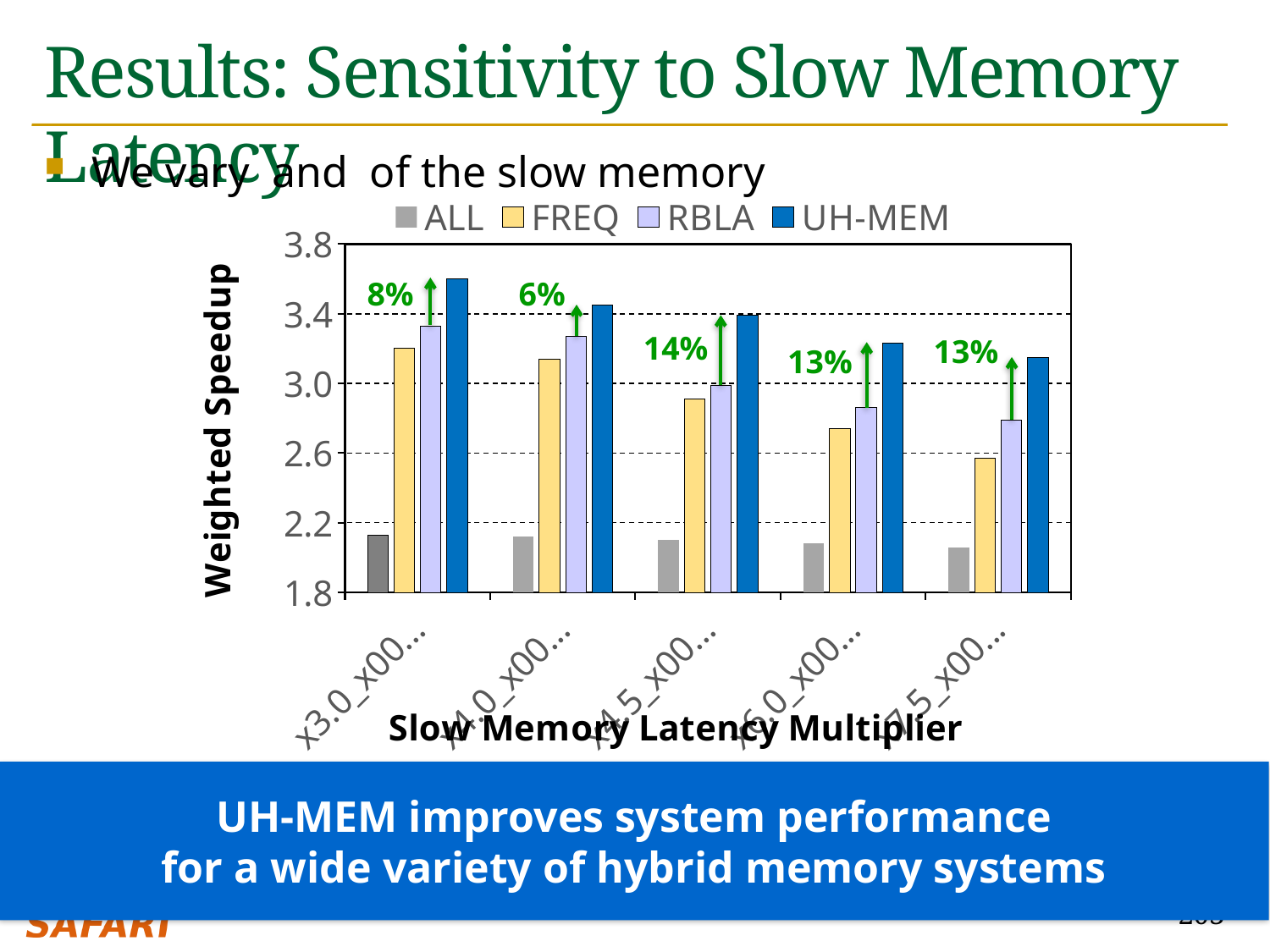
Which series has the shortest bar in every group? ALL Is the UH-MEM value for the x3.0 group greater or less than 3.4? greater What kind of chart is shown on the slide? bar chart Is the RBLA value for the x7.5 group greater or less than 3.0? less What is the title of the y axis? Weighted Speedup How many category groups are plotted along the x axis? 5 How many series does the legend list? 4 Do the UH-MEM values rise or fall as the slow memory latency multiplier increases along the x axis? fall Which series has the tallest bar in the first (x3.0) group? UH-MEM Is the FREQ value for the x4.5 group greater or less than 3.0? less Which is larger in the x6.0 group, the FREQ bar or the RBLA bar? RBLA What improvement percentage is annotated above the x4.5 group? 14%